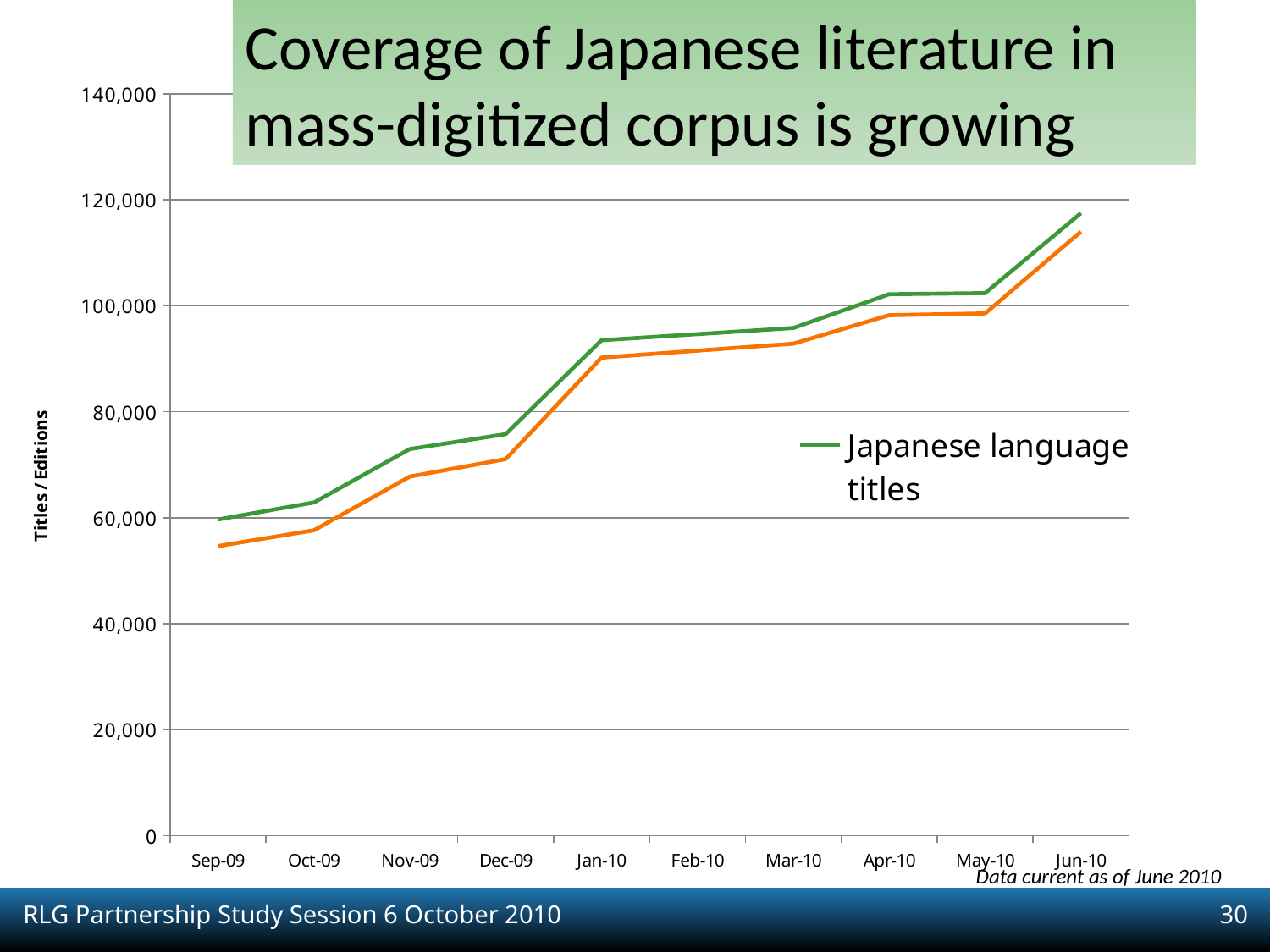
Do the values for Japanese language titles rise or fall from Sep-09 to Jun-10? rise Is the value for Japanese language titles in Jan-10 greater or less than 80,000? greater In which month is the value for Japanese language titles highest? Jun-10 How many months are plotted along the x axis of the chart? 10 Is the value for Japanese language titles in Sep-09 greater or less than 80,000? less What kind of chart is shown on the slide? line chart Is the value for Japanese language titles in Mar-10 greater or less than 100,000? less In which month is the value for Japanese language titles lowest? Sep-09 What is the title of the chart? Coverage of Japanese literature in mass-digitized corpus is growing Which is larger for Japanese language titles, the value in Jun-10 or the value in Sep-09? Jun-10 What is the label on the vertical axis of the chart? Titles / Editions